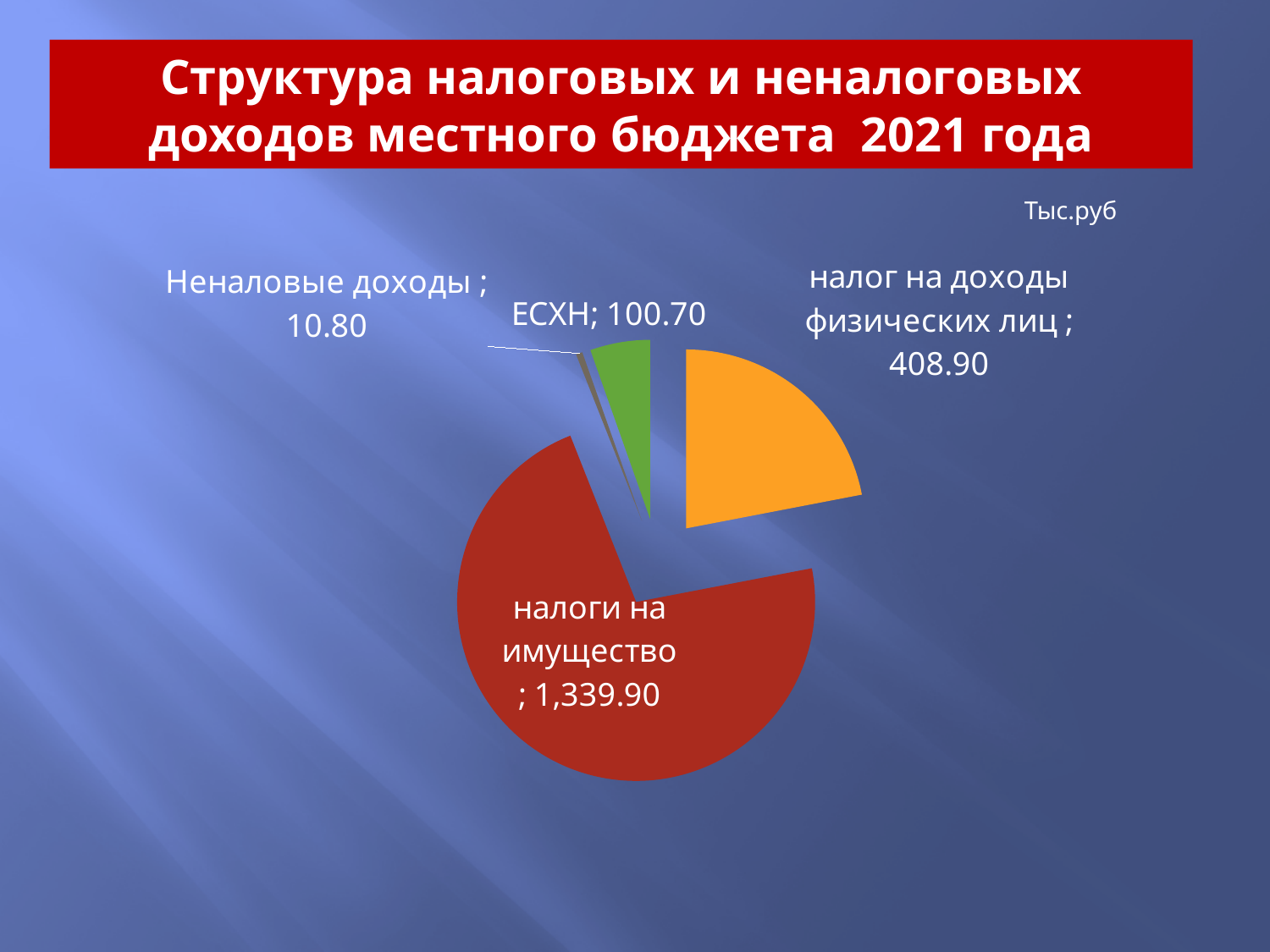
What is the value for ЕСХН? 100.70 How many slices does the pie chart have? 4 What type of chart is shown on the slide? pie chart What colour is the slice for налог на доходы физических лиц? orange What is the value for налоги на имущество? 1,339.90 Which category has the largest slice of the pie? налоги на имущество What unit of measurement is indicated for the chart values? Тыс.руб What is the value for Неналовые доходы? 10.80 What is the difference between the values for налоги на имущество and налог на доходы физических лиц? 931.00 Which is larger, the value for ЕСХН or the value for Неналовые доходы? ЕСХН Which category has the smallest slice of the pie? Неналовые доходы What is the value for налог на доходы физических лиц? 408.90